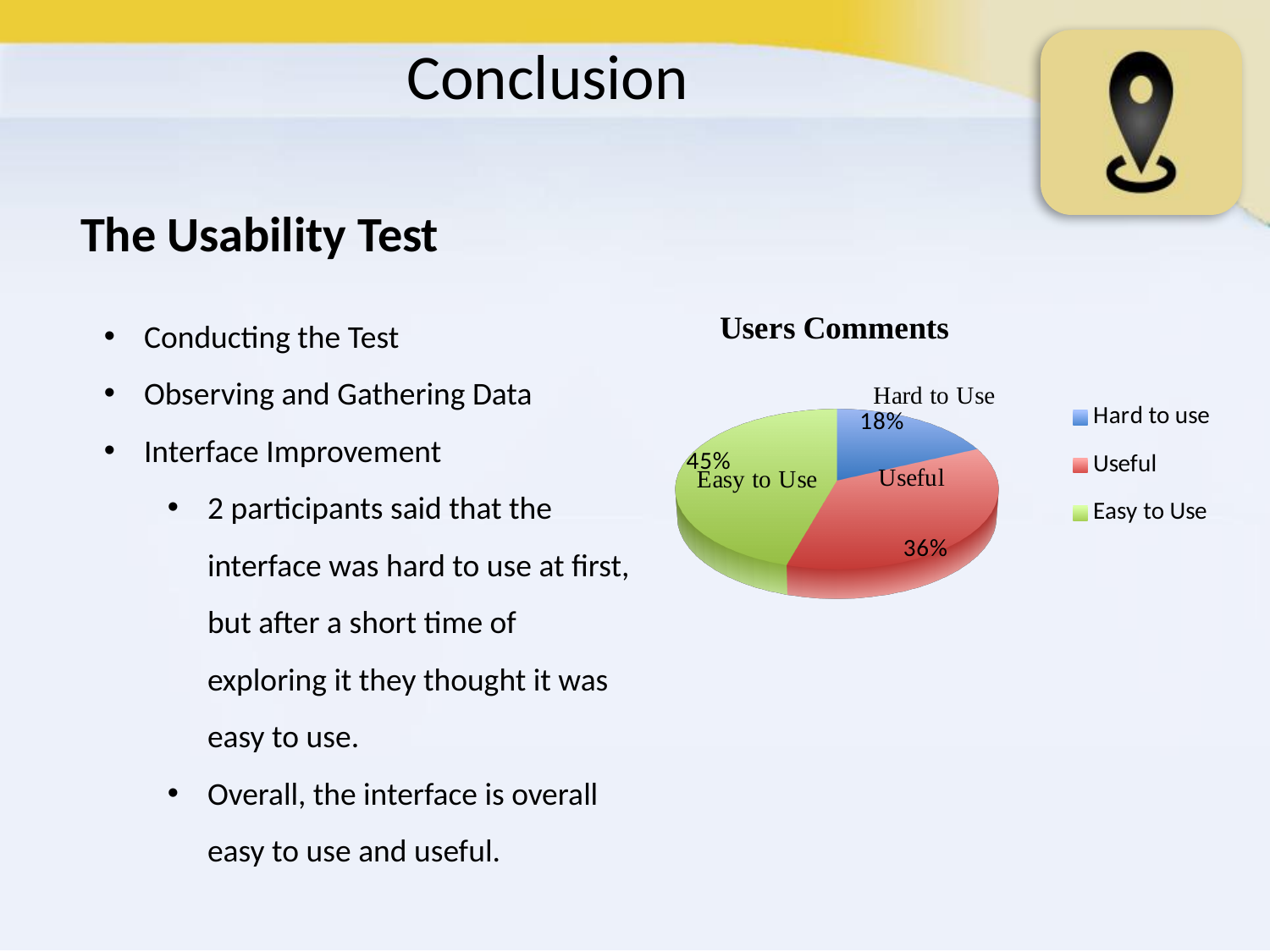
What is the title of the chart? Users Comments Which category has the largest share of the pie? Easy to Use What is the difference in percentage points between the Easy to Use slice and the Hard to Use slice? 27 How many entries does the legend list? 3 Which category has the smallest share of the pie? Hard to Use What percentage of the pie is labelled Useful? 36% What colour is the Useful slice in the pie chart? Red How many slices does the pie chart have? 3 What percentage of the pie is labelled Hard to Use? 18% Which slice is larger, Useful or Hard to Use? Useful What kind of chart is shown on the slide? Pie chart What percentage of the pie is labelled Easy to Use? 45%